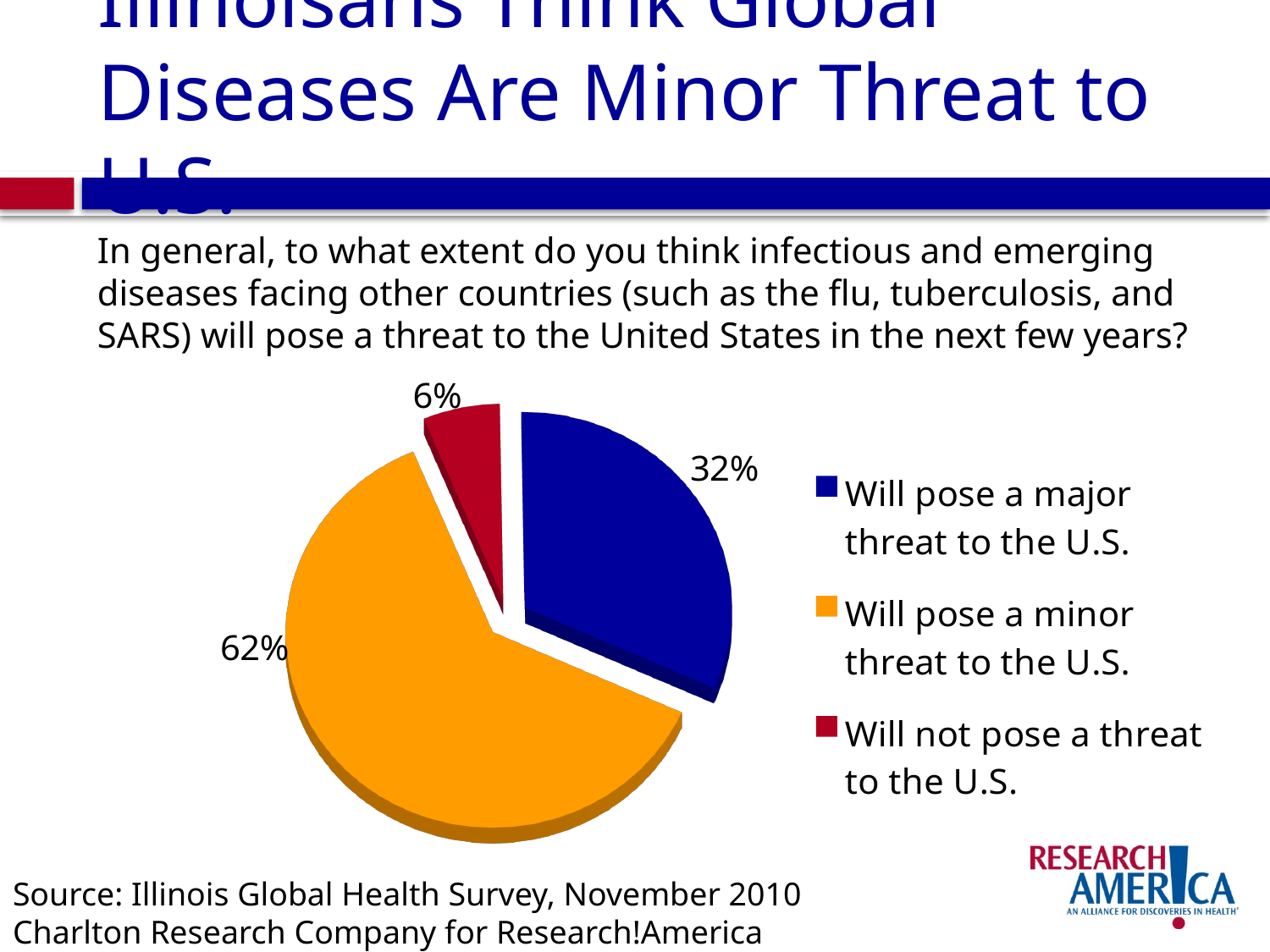
What is the combined percentage of respondents who said global diseases will pose either a major or a minor threat to the U.S.? 94% Which response has the smallest share of the pie? Will not pose a threat to the U.S. Which response has the largest share of the pie? Will pose a minor threat to the U.S. What is the difference in percentage points between the 'minor threat' and 'major threat' responses? 30 What colour is the slice for 'Will pose a minor threat to the U.S.'? Orange What percentage of respondents said global diseases will pose a major threat to the U.S.? 32% What kind of chart is shown on the slide? Pie chart What percentage of respondents said global diseases will pose a minor threat to the U.S.? 62% What percentage of respondents said global diseases will not pose a threat to the U.S.? 6% Which is larger: the share for 'Will pose a major threat to the U.S.' or 'Will not pose a threat to the U.S.'? Will pose a major threat to the U.S. How many entries does the legend list? 3 How many slices does the pie chart have? 3